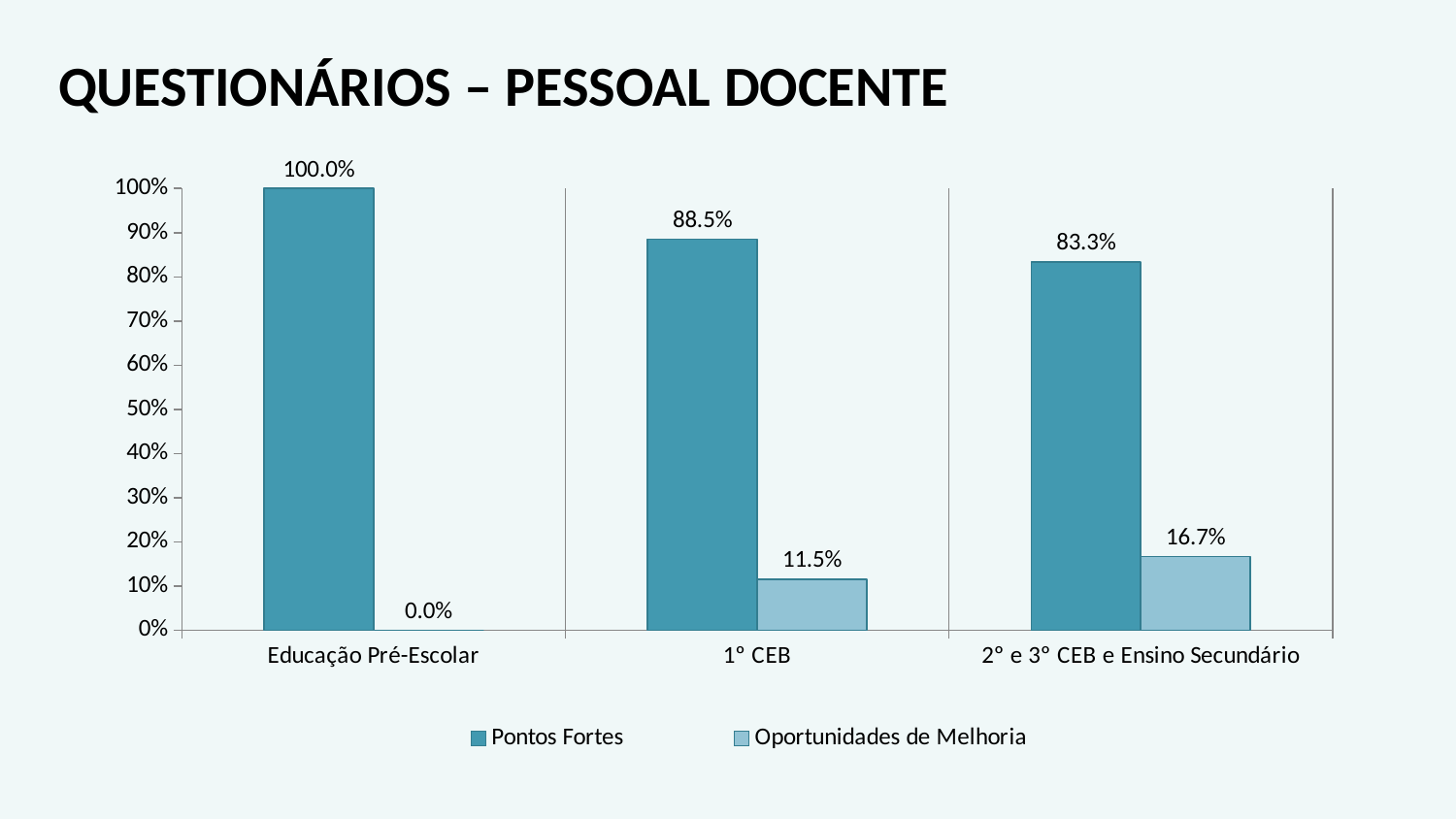
What is the value of Oportunidades de Melhoria for Educação Pré-Escolar? 0.0% What is the value of Pontos Fortes for 2° e 3° CEB e Ensino Secundário? 83.3% How many series does the legend list? 2 What is the value of Oportunidades de Melhoria for 1° CEB? 11.5% Which category has the highest Pontos Fortes value? Educação Pré-Escolar What is the difference between the Pontos Fortes values for 1° CEB and 2° e 3° CEB e Ensino Secundário? 5.2% Is the Pontos Fortes value for 1° CEB greater or less than 80%? greater Which is larger: Oportunidades de Melhoria for 1° CEB or for 2° e 3° CEB e Ensino Secundário? 2° e 3° CEB e Ensino Secundário What is the value of Pontos Fortes for Educação Pré-Escolar? 100.0% Which category has the lowest Oportunidades de Melhoria value? Educação Pré-Escolar How many categories are shown on the x axis? 3 What kind of chart is shown on the slide? bar chart